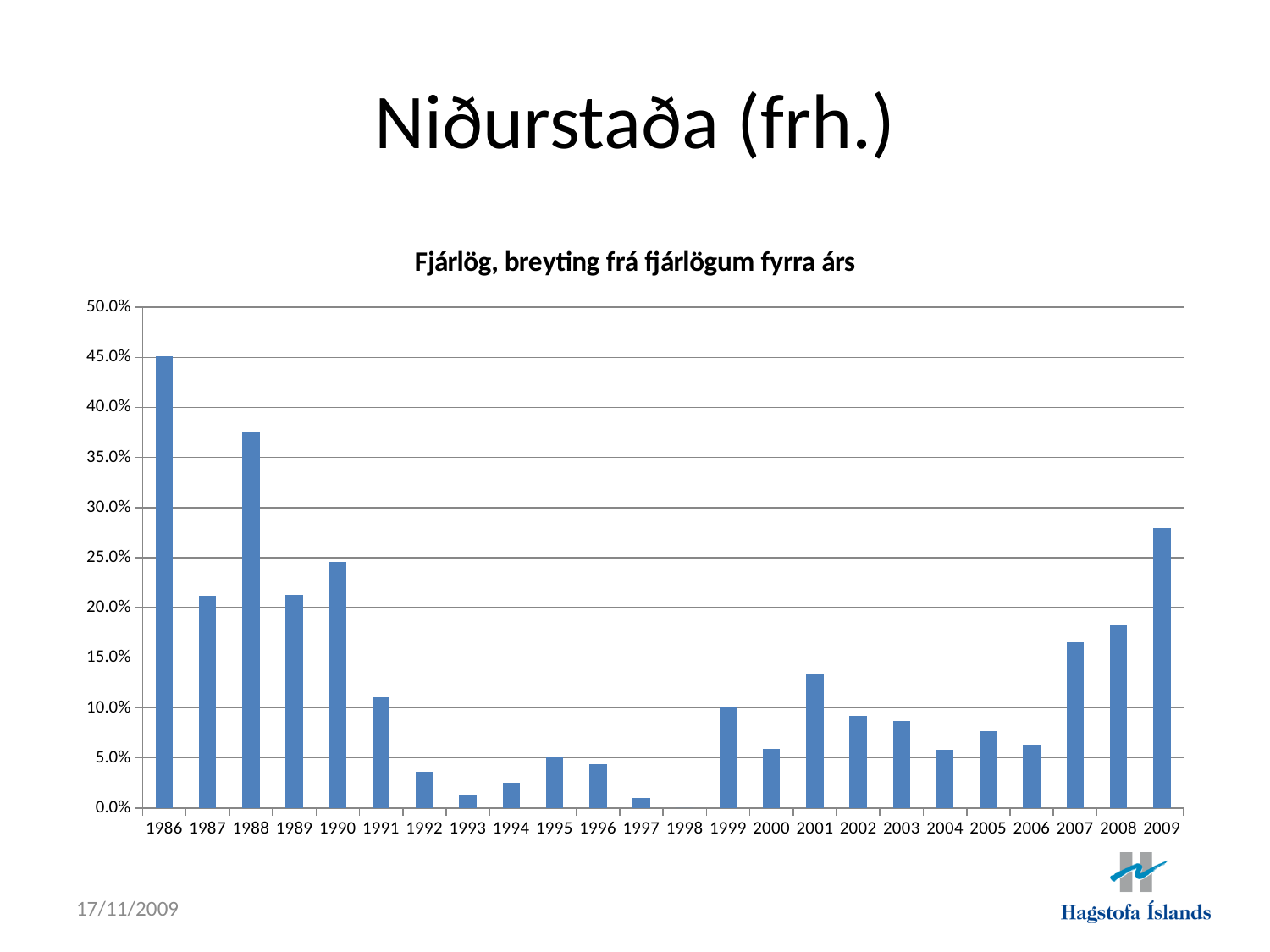
Is the value for 1986 greater or less than 40.0%? greater What is the title of the chart? Fjárlög, breyting frá fjárlögum fyrra árs Is the value for 2008 greater or less than 20.0%? less Is the value for 2009 greater or less than 25.0%? greater Which is larger, the value for 2001 or the value for 2002? 2001 Which is larger, the value for 1986 or the value for 1988? 1986 How many years are labelled on the x axis of the chart? 24 Which year has the highest value in the chart? 1986 What kind of chart is shown on the slide? Bar chart Do the values rise or fall from 2006 to 2009? rise